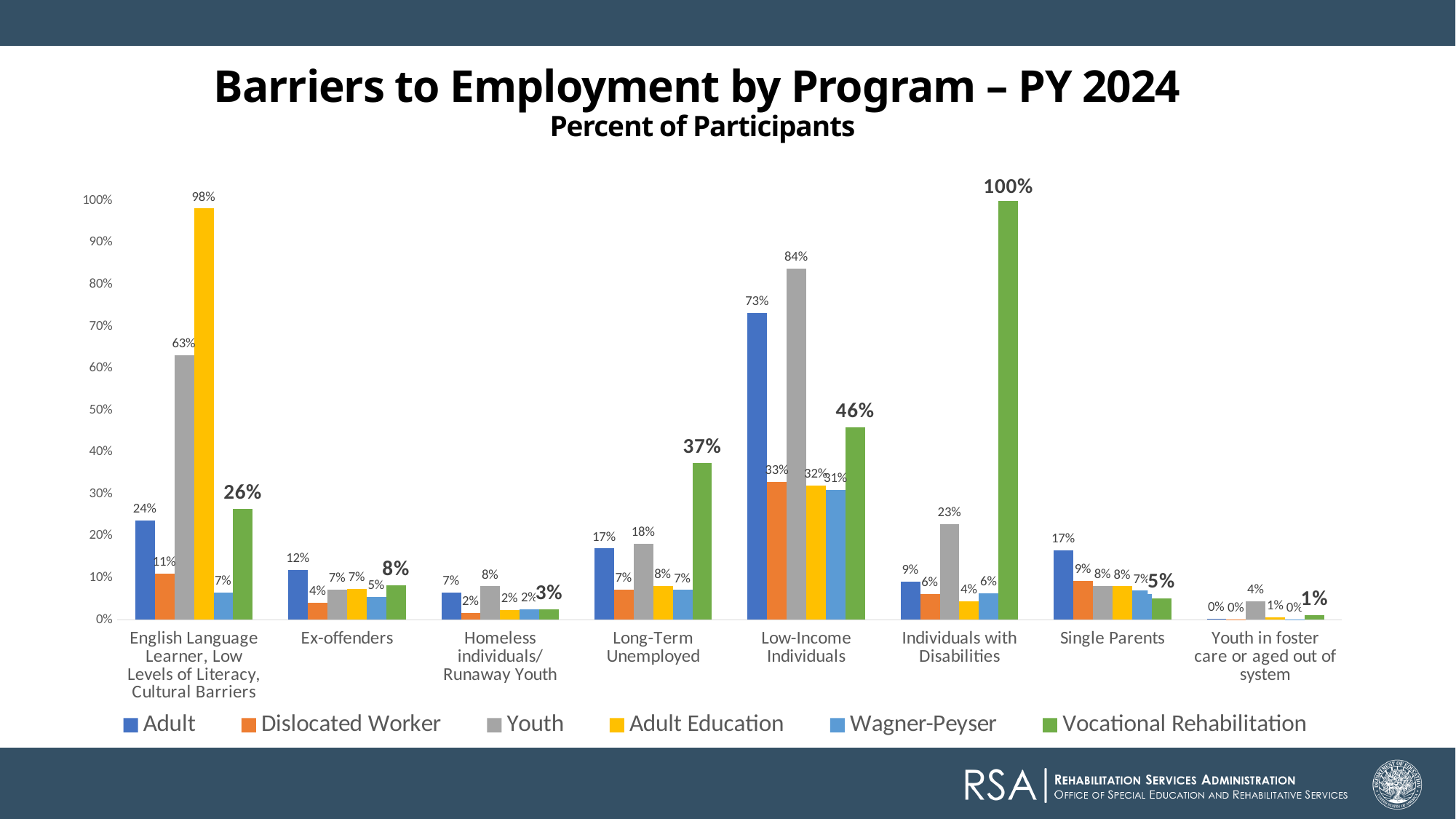
Which program has the lowest value for Single Parents? Vocational Rehabilitation What is the Vocational Rehabilitation value for Individuals with Disabilities? 100% What is the Vocational Rehabilitation value for Low-Income Individuals? 46% How many series does the legend list? 6 Which program has the highest value for Long-Term Unemployed? Vocational Rehabilitation What is the Adult Education value for English Language Learner, Low Levels of Literacy, Cultural Barriers? 98% What is the Youth value for Low-Income Individuals? 84% For Ex-offenders, which is larger: the Adult value or the Dislocated Worker value? Adult What is the difference between the Youth and Adult values for Low-Income Individuals? 11% How many barrier categories are shown on the x axis? 8 Which series is shown in green in the legend? Vocational Rehabilitation What type of chart is shown on the slide? bar chart